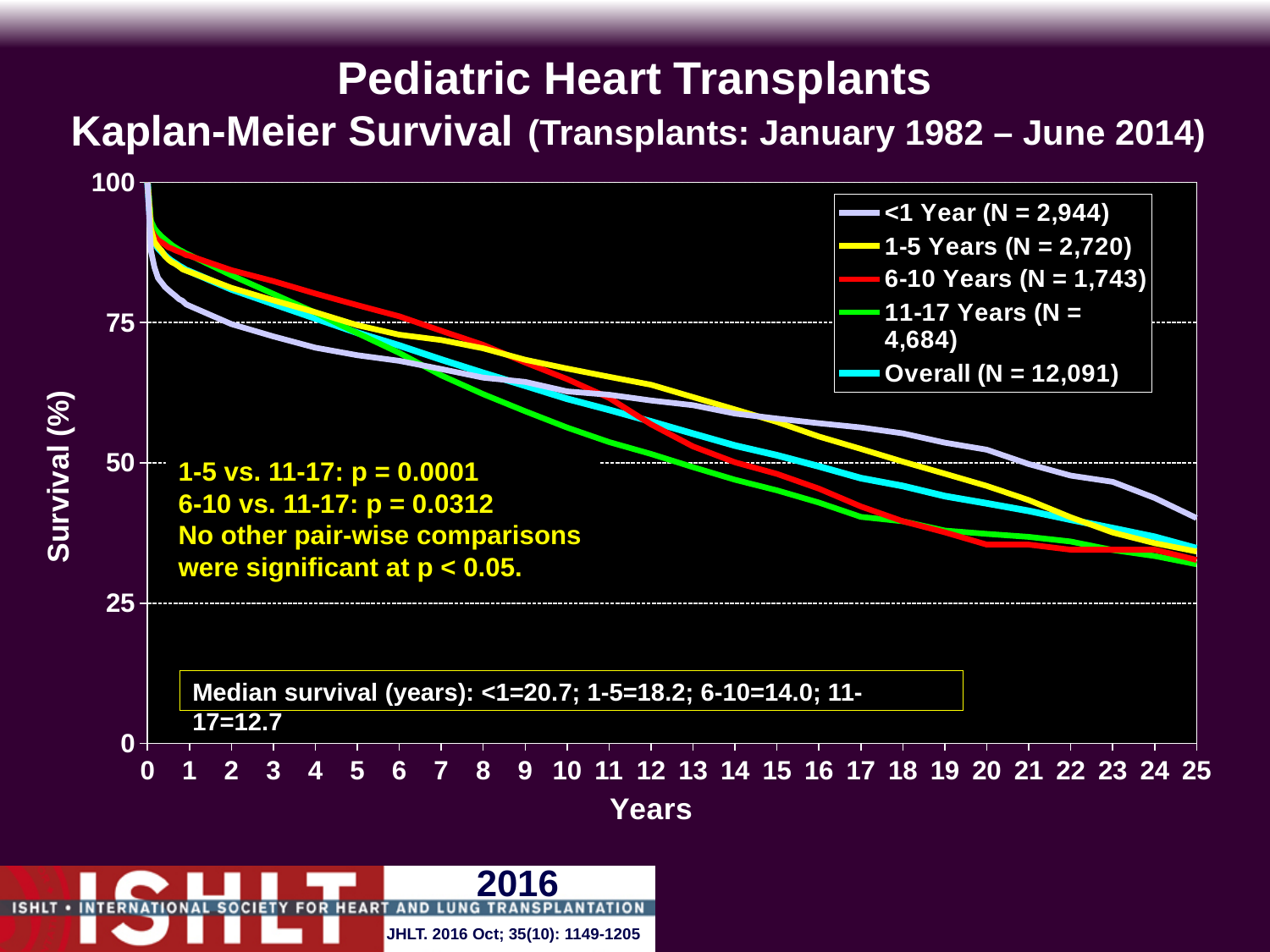
What is the N for the 11-17 Years group shown in the legend? 4,684 What is the p-value for the 1-5 vs. 11-17 comparison shown on the slide? 0.0001 What kind of chart is shown on the slide? line chart Which group has the lowest survival at 1 year? <1 Year Is the survival for the <1 Year group at 25 years greater or less than 25? greater Is the survival for the 11-17 Years group at 20 years greater or less than 50? less How many series does the legend list? 5 What is the N for the <1 Year group shown in the legend? 2,944 Do the survival curves rise or fall as years since transplant increase? fall What is the median survival in years for the 6-10 group, as stated on the slide? 14.0 What is the N for the Overall group shown in the legend? 12,091 Which group has the highest survival at 25 years? <1 Year